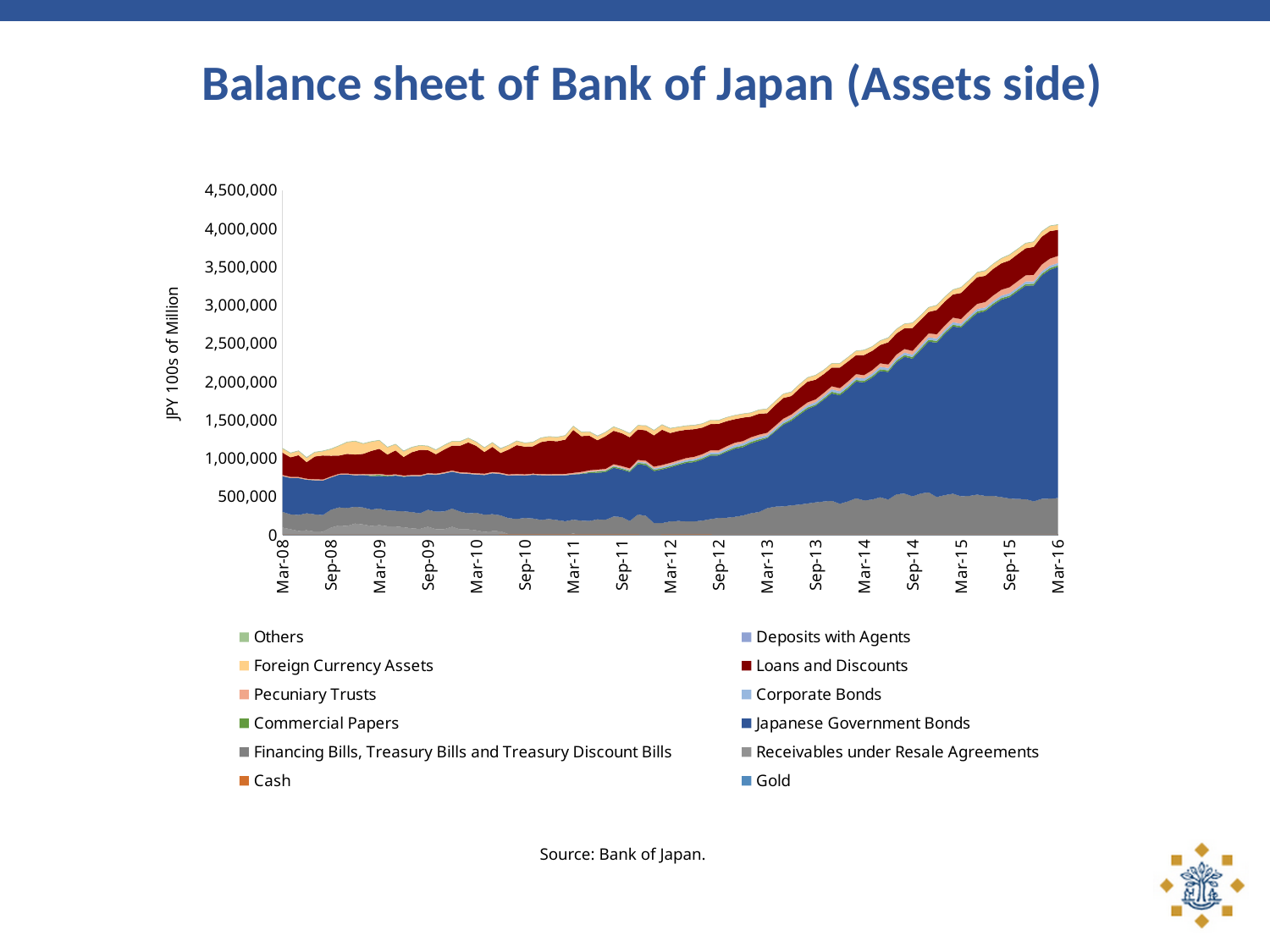
Is the total stacked value at Mar-16 greater or less than 3,500,000? greater How many date labels are shown on the x axis? 17 At Mar-16, which is larger: Japanese Government Bonds or Loans and Discounts? Japanese Government Bonds Do total assets rise or fall from Mar-08 to Mar-16? Rise Is the total stacked value at Mar-10 greater or less than 1,500,000? less Which series makes up the largest part of the stack at Mar-16? Japanese Government Bonds How many series does the legend list? 12 Is the total stacked value at Mar-08 greater or less than 1,500,000? less What kind of chart is shown on the slide? Stacked area chart What unit is given on the vertical axis label? JPY 100s of Million What is the title of the chart? Balance sheet of Bank of Japan (Assets side)